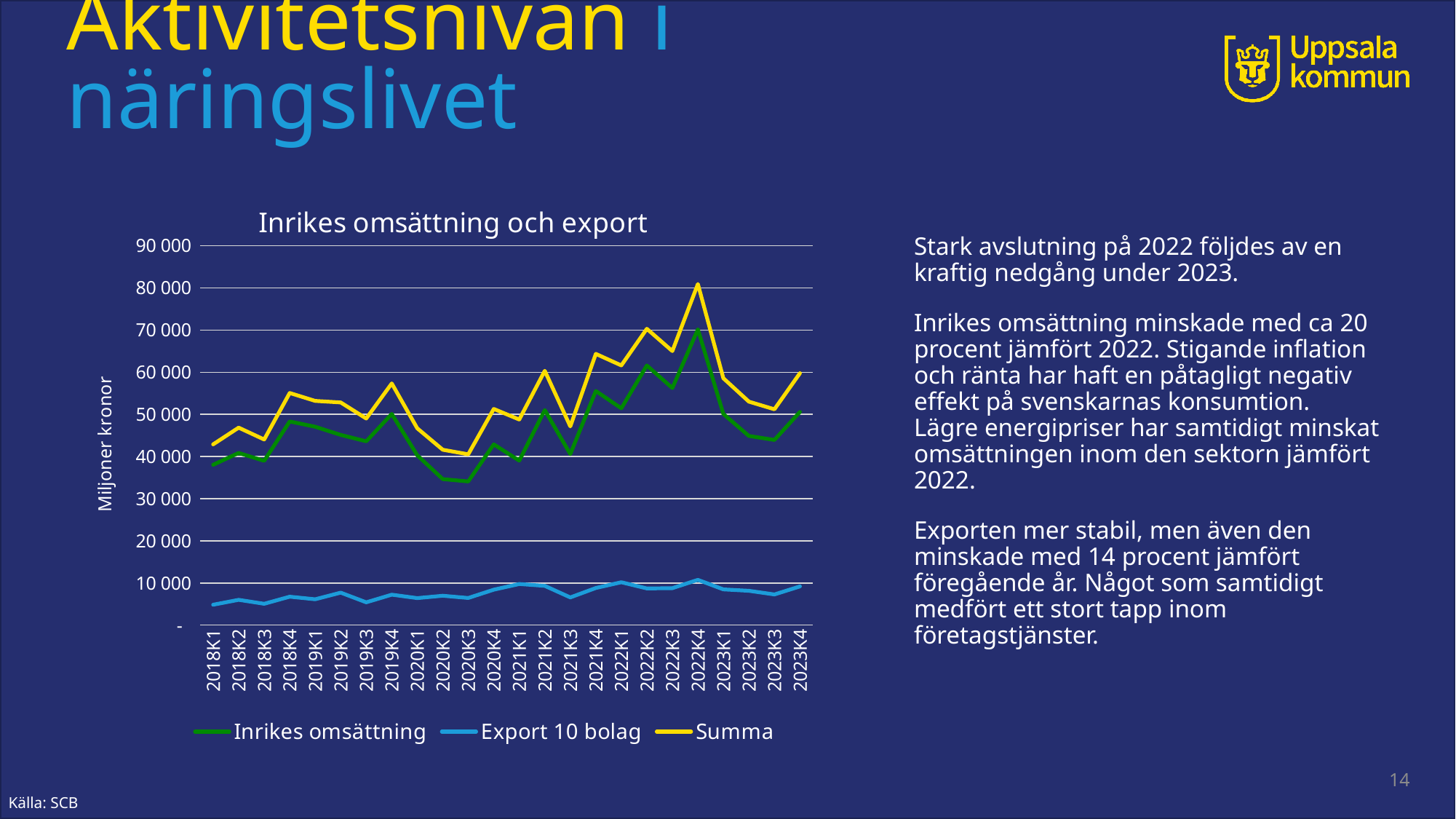
What kind of chart is shown on the slide? Line chart Which series is higher in 2021K2, Inrikes omsättning or Export 10 bolag? Inrikes omsättning How many series does the legend of the chart list? 3 What is the title of the chart? Inrikes omsättning och export Is the value of Export 10 bolag in 2018K1 greater or less than 10 000? less In which quarter does the Summa series reach its highest value? 2022K4 How many quarters are plotted along the x axis of the chart? 24 Does the Inrikes omsättning series rise or fall from 2022K4 to 2023K3? Fall Is the value of Summa in 2022K4 greater or less than 70 000? greater In which quarter does the Inrikes omsättning series reach its highest value? 2022K4 What is the label on the y axis of the chart? Miljoner kronor Is the value of Inrikes omsättning in 2020K2 greater or less than 40 000? less